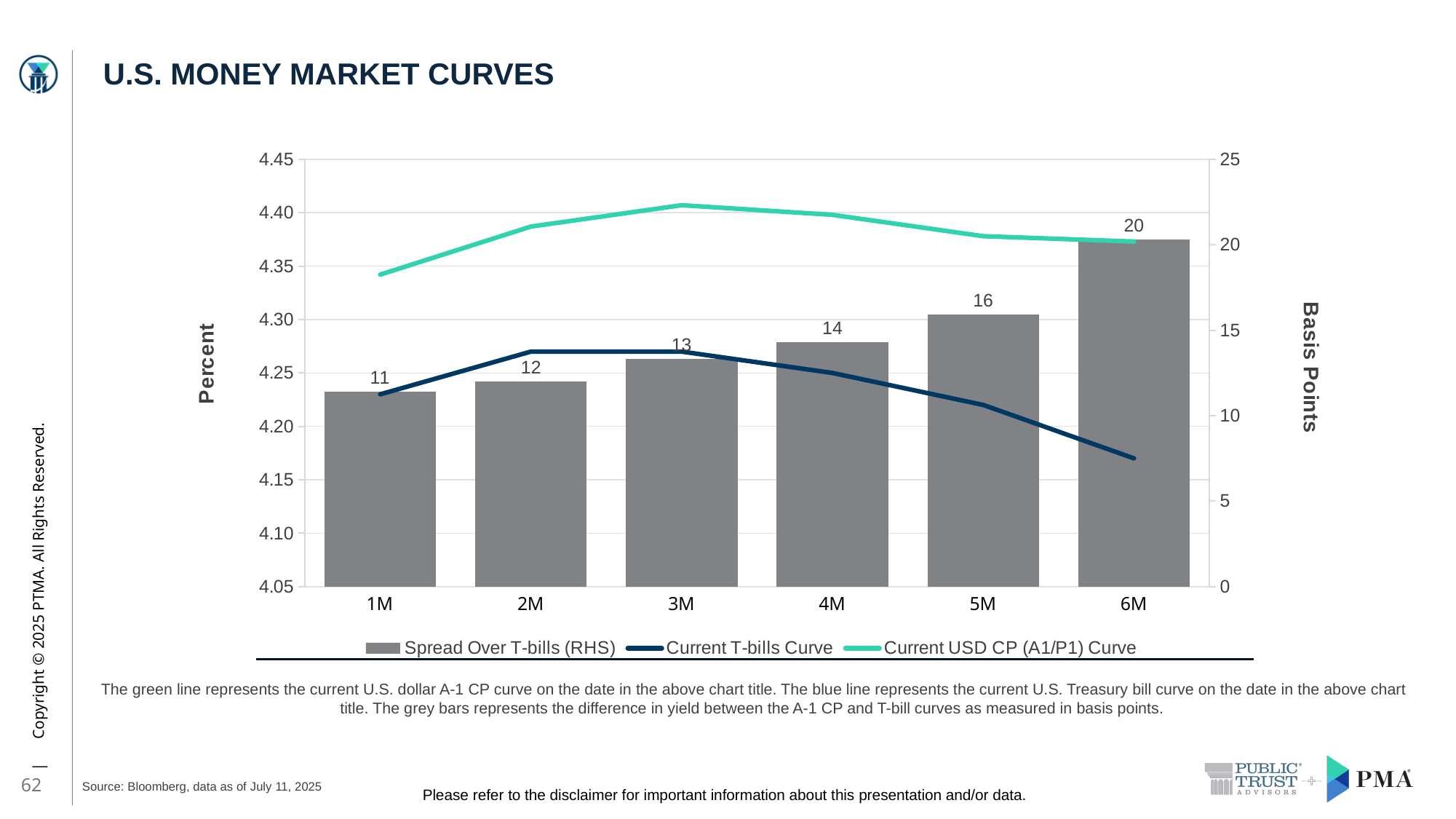
At which maturity is the Spread Over T-bills lowest? 1M How many series does the legend list? 3 At which maturity is the Spread Over T-bills highest? 6M What is the title of the right-hand vertical axis? Basis Points Is the value of the Current USD CP (A1/P1) Curve at 1M greater or less than 4.30? greater Which has a larger Spread Over T-bills, 4M or 5M? 5M How many maturity categories are shown on the x axis? 6 What is the difference between the Spread Over T-bills at 6M and at 1M? 9 What is the Spread Over T-bills value at 6M? 20 Is the value of the Current T-bills Curve at 6M greater or less than 4.20? less Do the Spread Over T-bills bars rise or fall from 1M to 6M? rise What is the Spread Over T-bills value at 3M? 13